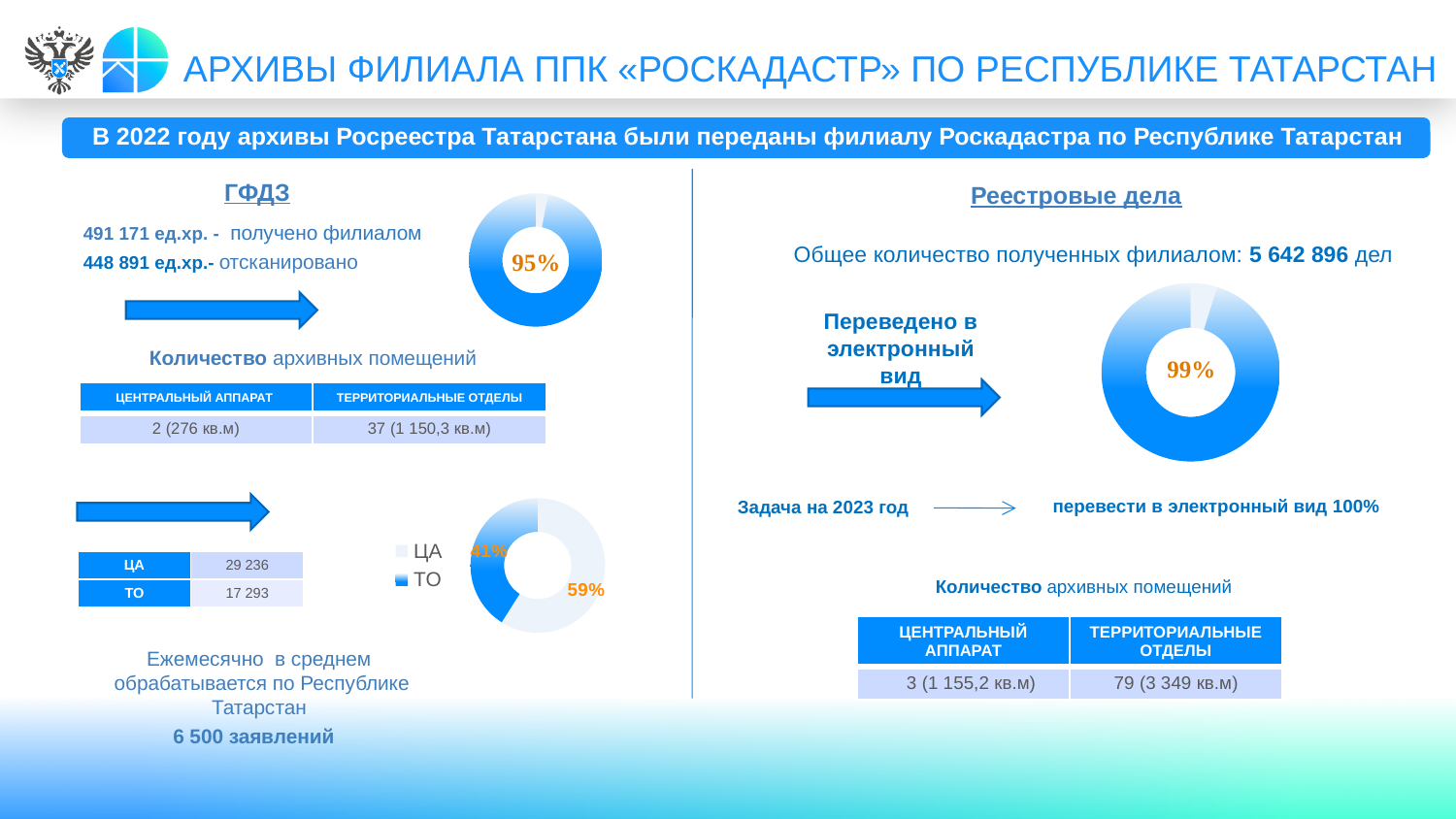
In the legend of the bottom-left donut chart, which entry is shown in blue? ТО On the ГФДЗ donut chart at the top left, what percentage is printed in the centre? 95% How many entries does the legend of the bottom-left donut chart list? 2 On the Реестровые дела donut chart on the right, what percentage is printed in the centre? 99% On the bottom-left donut chart, what is the difference between the two printed percentages, 59% and 41%? 18 percentage points What kind of chart is used on the right side of the slide under Реестровые дела? Pie (donut) chart Which two percentage labels are printed on the bottom-left donut chart? 41% and 59% Which donut chart shows the higher percentage, the ГФДЗ chart (top left) or the Реестровые дела chart (right)? Реестровые дела chart (99%) How many donut charts are shown on the slide? 3 What are the two legend entries of the bottom-left donut chart? ЦА and ТО What is the difference between the percentage on the Реестровые дела donut chart (99%) and the ГФДЗ donut chart (95%)? 4 percentage points Is the percentage shown on the ГФДЗ donut chart greater or less than 90%? greater